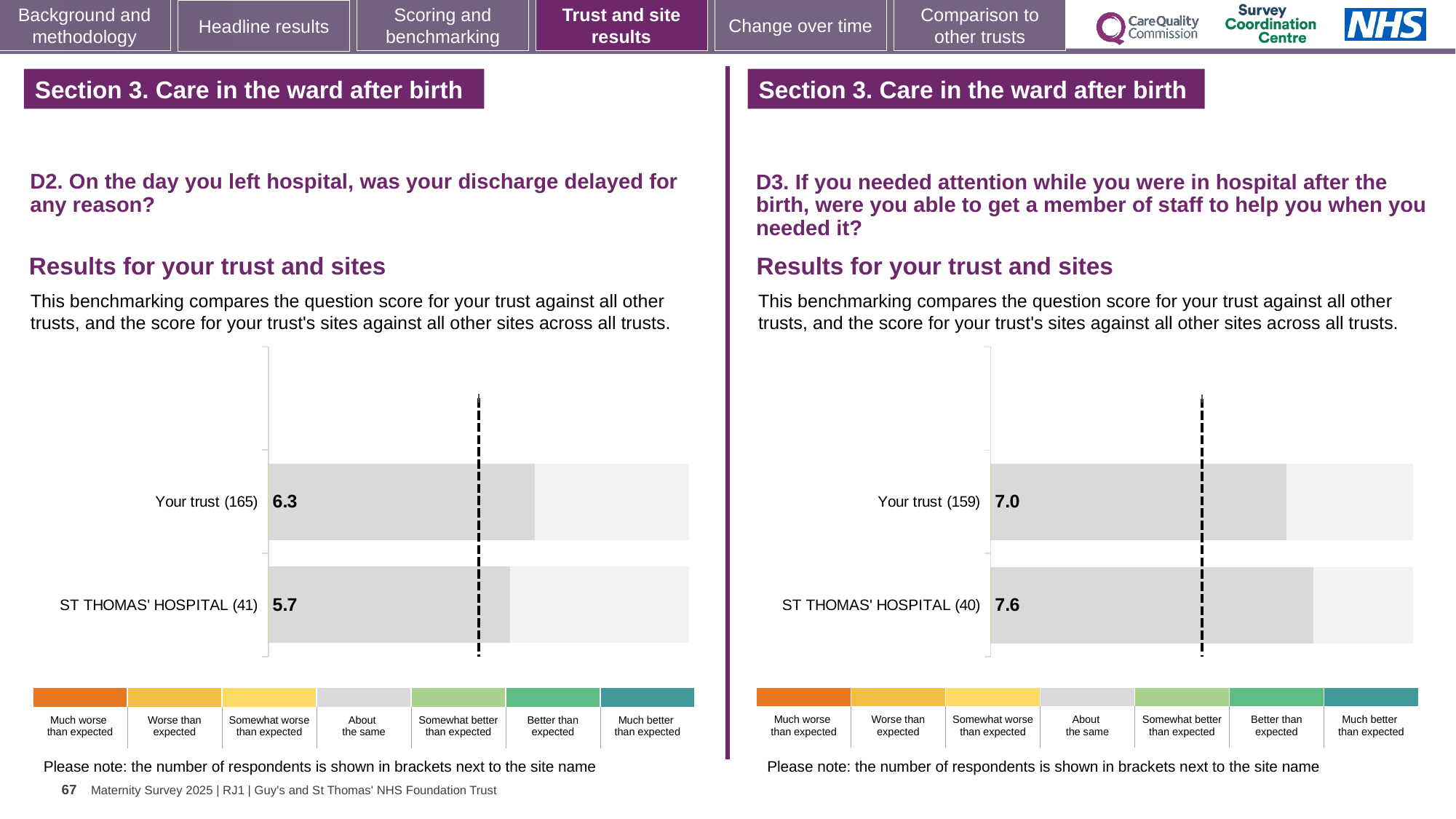
In the D2 chart on the left, which bar has the higher score? Your trust What kind of chart is used in the D3 chart on the right? bar chart In the D2 chart on the left, how many respondents are shown in brackets next to ST THOMAS' HOSPITAL? 41 In the D3 chart on the right, which bar has the lower score? Your trust In the D3 chart on the right, what is the score for Your trust? 7.0 In the D3 chart on the right, is the score for ST THOMAS' HOSPITAL larger or smaller than the score for Your trust? larger In the D3 chart on the right, what is the score for ST THOMAS' HOSPITAL? 7.6 In the D2 chart on the left, what is the score for ST THOMAS' HOSPITAL? 5.7 In the D3 chart on the right, what is the difference between the score for ST THOMAS' HOSPITAL and the score for Your trust? 0.6 How many bars are plotted in the D2 chart on the left? 2 In the D2 chart on the left, what is the difference between the score for Your trust and the score for ST THOMAS' HOSPITAL? 0.6 In the D2 chart on the left, what is the score for Your trust? 6.3